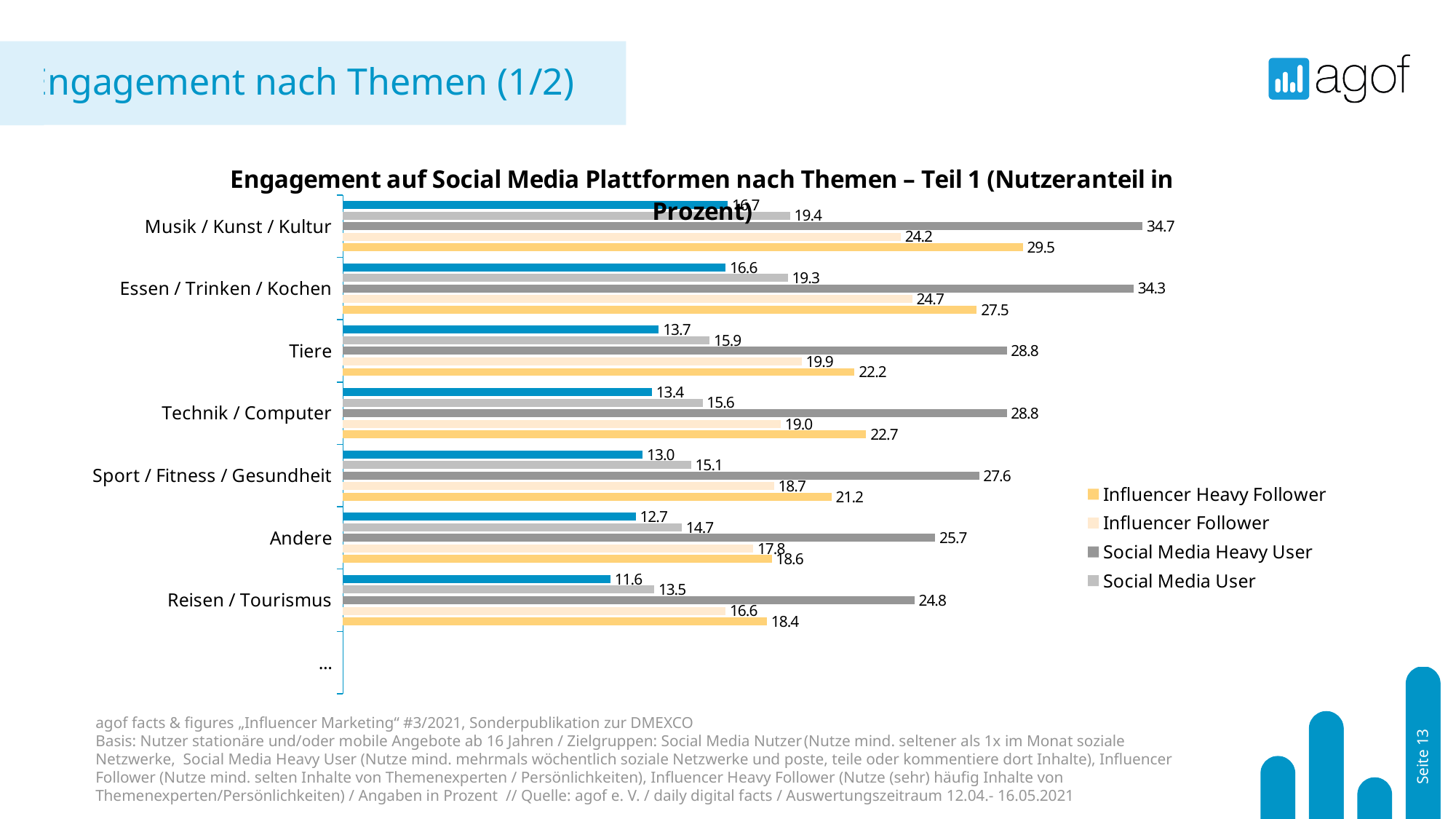
Which category has the highest value for Social Media Heavy User? Musik / Kunst / Kultur How many series does the legend list? 4 What kind of chart is shown on the slide? Bar chart Which is larger for Technik / Computer: the Influencer Heavy Follower value or the Influencer Follower value? Influencer Heavy Follower Which category has the lowest value for Influencer Heavy Follower? Reisen / Tourismus Which legend entry is shown in the darkest grey colour? Social Media Heavy User What is the difference between the Influencer Heavy Follower values for Musik / Kunst / Kultur and Andere? 10.9 What is the value for Social Media User in the Reisen / Tourismus category? 13.5 What is the value for Social Media Heavy User in the Musik / Kunst / Kultur category? 34.7 What is the value for Influencer Follower in the Tiere category? 19.9 What is the value for Influencer Heavy Follower in the Essen / Trinken / Kochen category? 27.5 What is the difference between the Social Media Heavy User and Social Media User values for Sport / Fitness / Gesundheit? 12.5